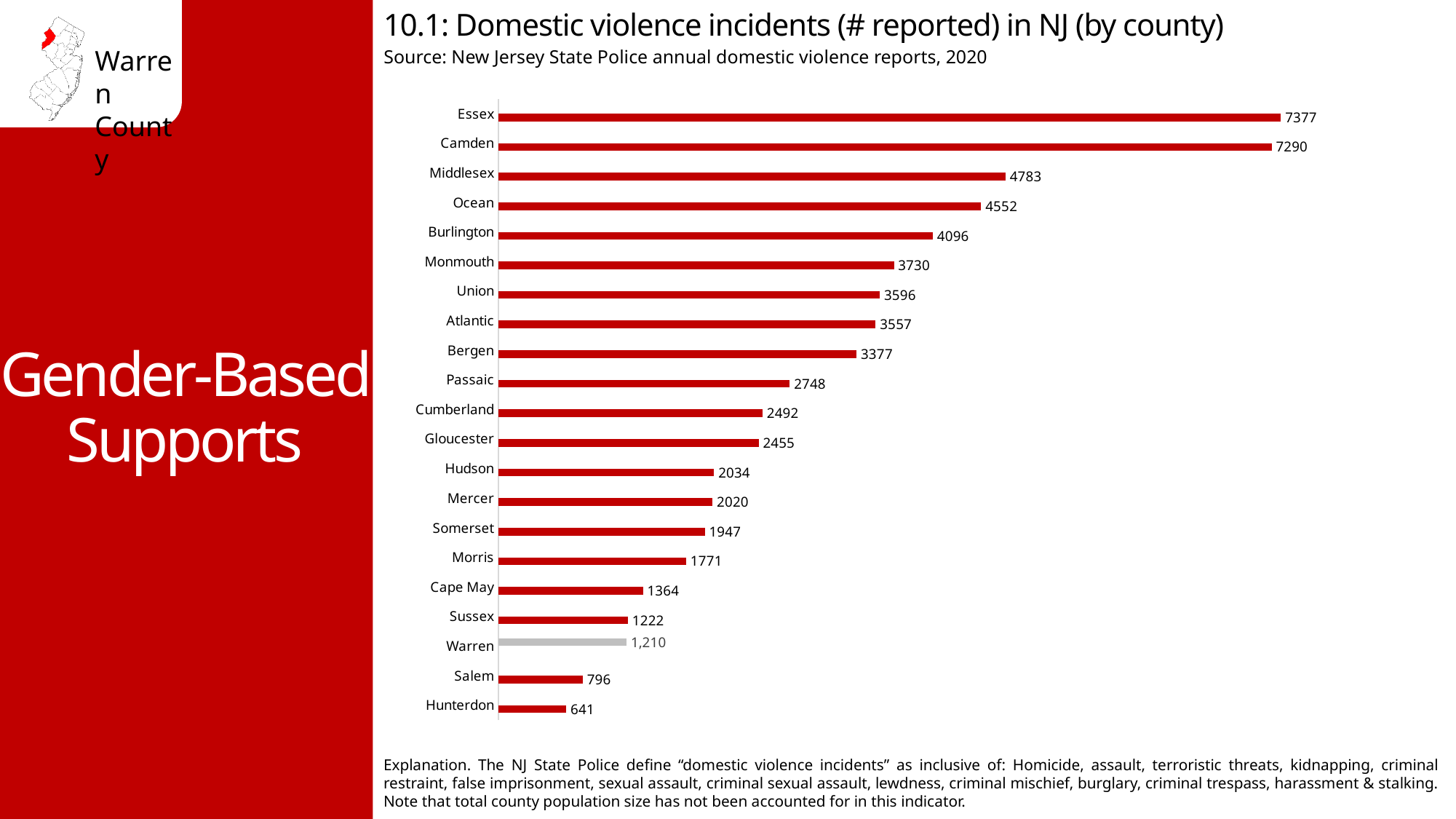
Which county has the lowest number of reported domestic violence incidents? Hunterdon Which county has the highest number of reported domestic violence incidents? Essex Which has more reported domestic violence incidents, Middlesex or Ocean? Middlesex What is the difference between the values for Sussex and Warren? 12 What is the number of reported domestic violence incidents for Essex? 7377 What is the difference between the values for Essex and Camden? 87 Which county's bar is shown in grey rather than red? Warren What kind of chart is shown on the slide? Bar chart How many counties are shown in the chart? 21 What is the number of reported domestic violence incidents for Warren County? 1,210 What is the number of reported domestic violence incidents for Monmouth? 3730 Which has more reported domestic violence incidents, Salem or Cape May? Cape May